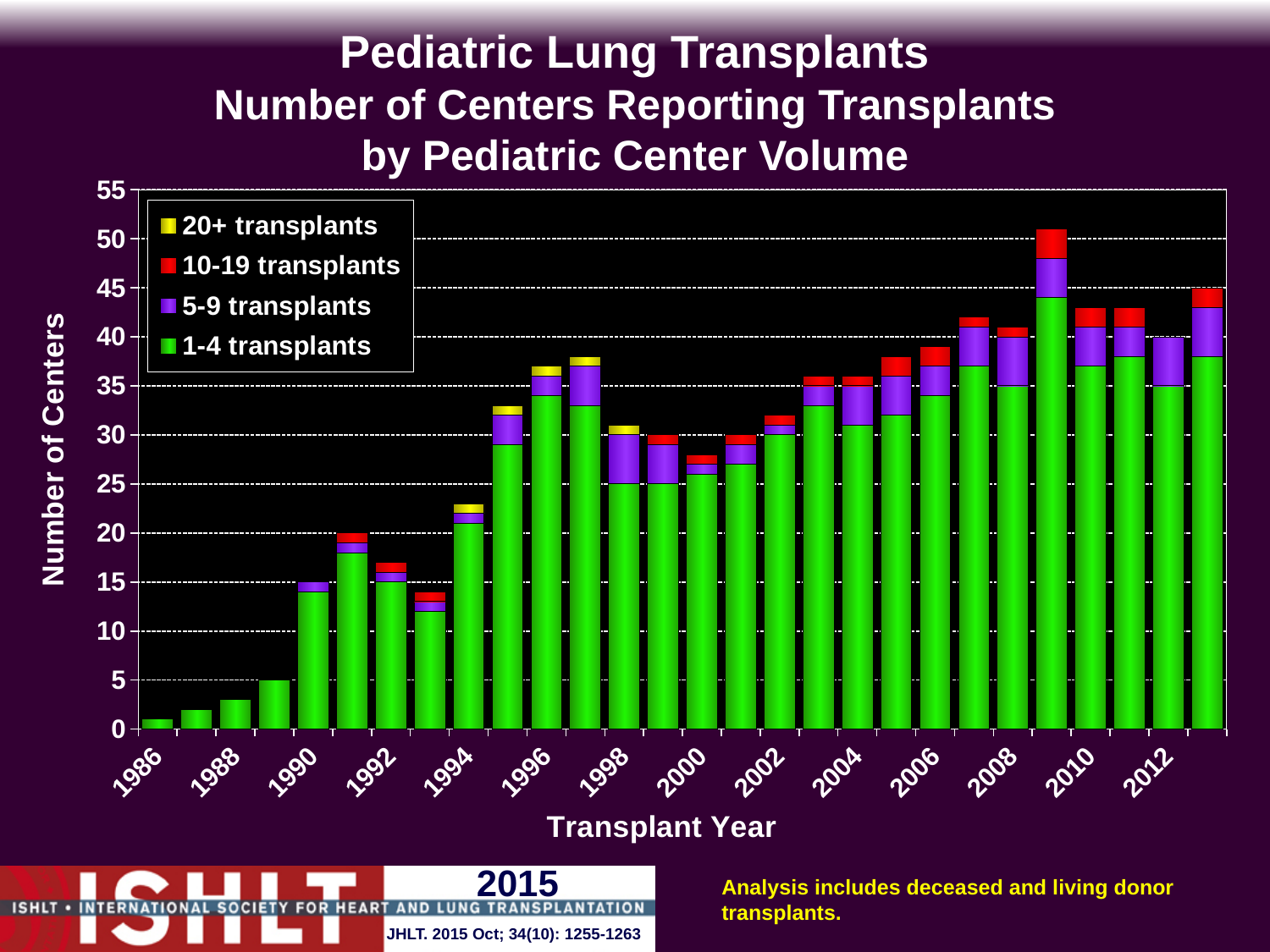
What is the title of the y axis? Number of Centers Which transplant year has the highest total number of centers? 2009 Is the total number of centers for 2009 greater or less than 45? greater Is the total number of centers for 1996 greater or less than 35? greater How many series does the legend list? 4 Is the total number of centers for 1994 greater or less than 20? greater What kind of chart is shown on the slide? Stacked bar chart Does the total number of centers rise or fall from 1986 to 1990? Rise Which year has a larger total number of centers, 2009 or 2010? 2009 Which transplant year has the lowest total number of centers? 1986